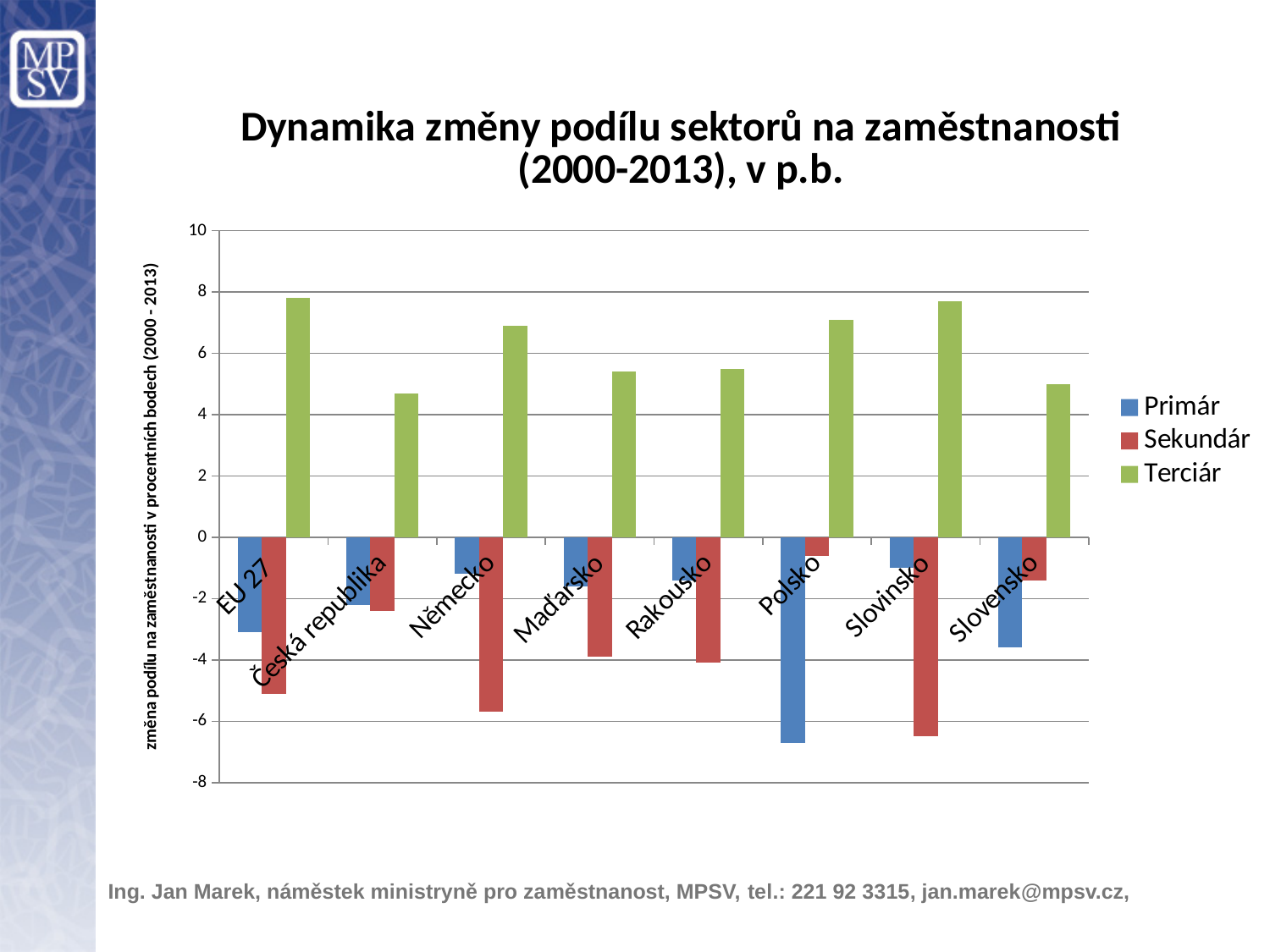
Which category has the lowest Sekundár value? Slovinsko Which category has the lowest Primár value? Polsko How many countries/regions are shown on the x axis? 8 How many series does the legend list? 3 What is the title of the chart? Dynamika změny podílu sektorů na zaměstnanosti (2000-2013), v p.b. What kind of chart is shown on the slide? bar chart Which is larger, the Terciár value for Německo or for Maďarsko? Německo Is the Terciár value for Česká republika greater or less than 6? less Is the Terciár value for Německo greater or less than 6? greater Is the Sekundár value for EU 27 greater or less than -4? less Which category has the highest (least negative) Sekundár value? Polsko